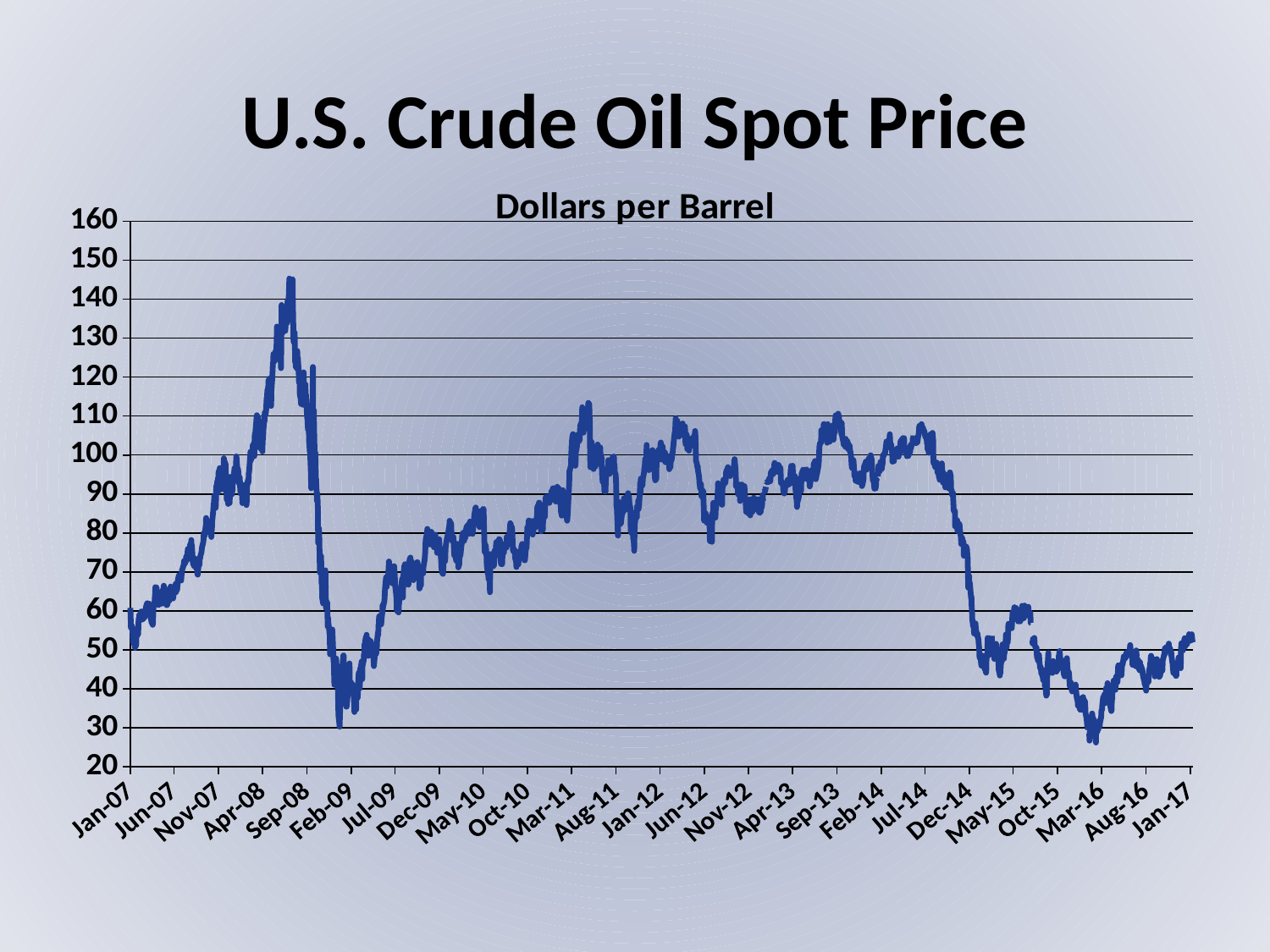
Is the value around Feb-09 greater or less than 50? less Is the value around Mar-16 greater or less than 40? less How many date labels are shown along the x axis? 25 Near which x-axis label does the crude oil price reach its highest point? Sep-08 What is the title of the chart? U.S. Crude Oil Spot Price Is the value at Jan-07 greater or less than 70? less Does the price rise or fall between Jul-14 and Mar-16? fall Which is higher, the price around Sep-08 or the price around Feb-09? Sep-08 What unit is the price measured in, according to the chart subtitle? Dollars per Barrel What kind of chart is shown on the slide? line chart